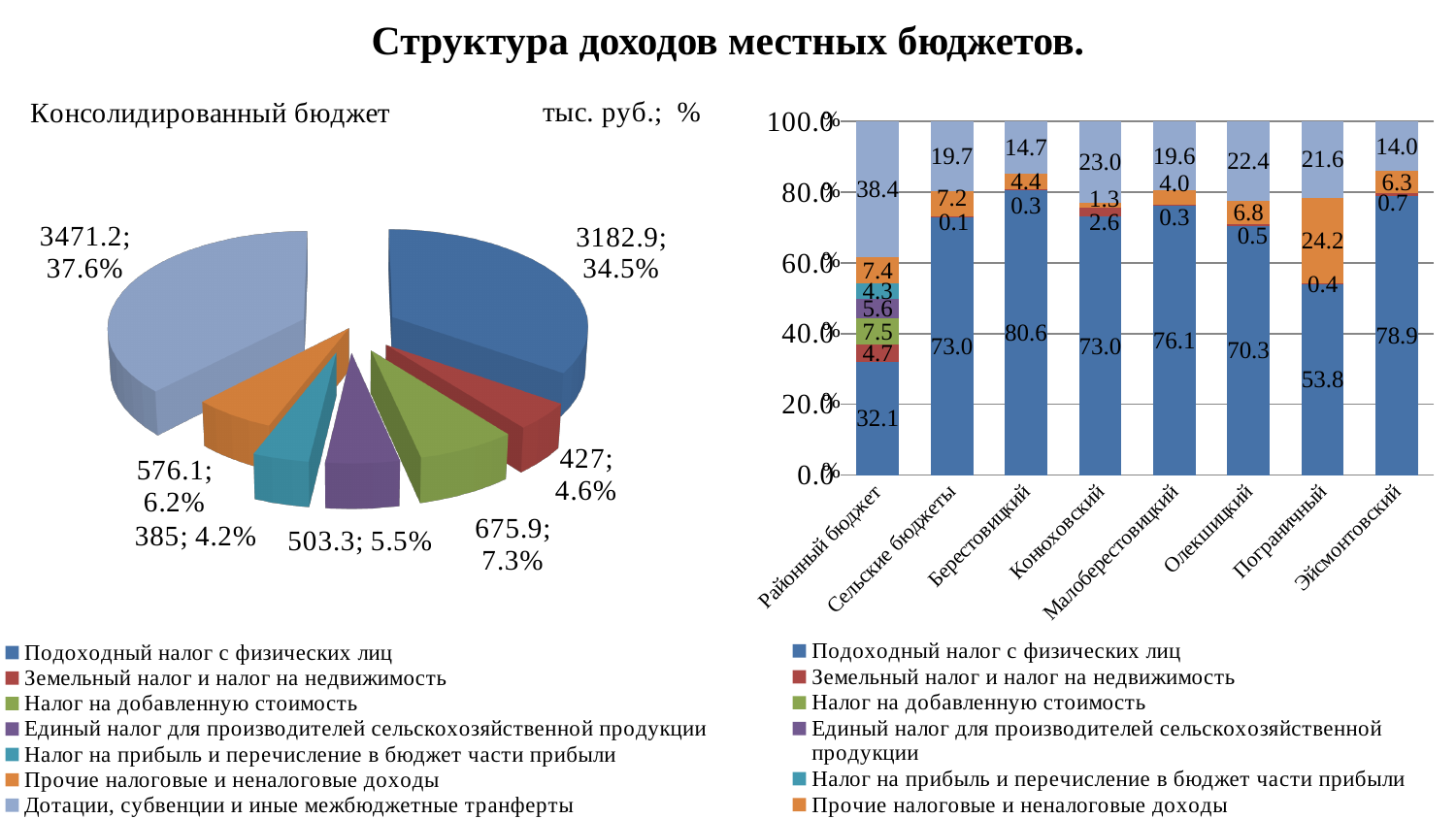
In the pie chart 'Консолидированный бюджет', which category has the smallest slice? Налог на прибыль и перечисление в бюджет части прибыли In the right stacked bar chart, what is the value of 'Прочие налоговые и неналоговые доходы' for Пограничный? 24.2 In the right stacked bar chart, which category has the lowest value for 'Подоходный налог с физических лиц'? Районный бюджет In the right stacked bar chart, which category has the highest value for 'Подоходный налог с физических лиц'? Берестовицкий How many entries does the legend of the left pie chart list? 7 What kind of chart is the left chart 'Консолидированный бюджет'? Pie chart In the right stacked bar chart, what is the difference between the 'Подоходный налог с физических лиц' values for Берестовицкий and Пограничный? 26.8 In the pie chart 'Консолидированный бюджет', what value in тыс. руб. is shown for 'Подоходный налог с физических лиц'? 3182.9 In the pie chart 'Консолидированный бюджет', what share is shown for 'Дотации, субвенции и иные межбюджетные трансферты'? 37.6% In the right stacked bar chart, what is the value of 'Подоходный налог с физических лиц' for Берестовицкий? 80.6 How many categories are shown on the x axis of the right stacked bar chart? 8 In the pie chart 'Консолидированный бюджет', which category has the largest slice? Дотации, субвенции и иные межбюджетные трансферты